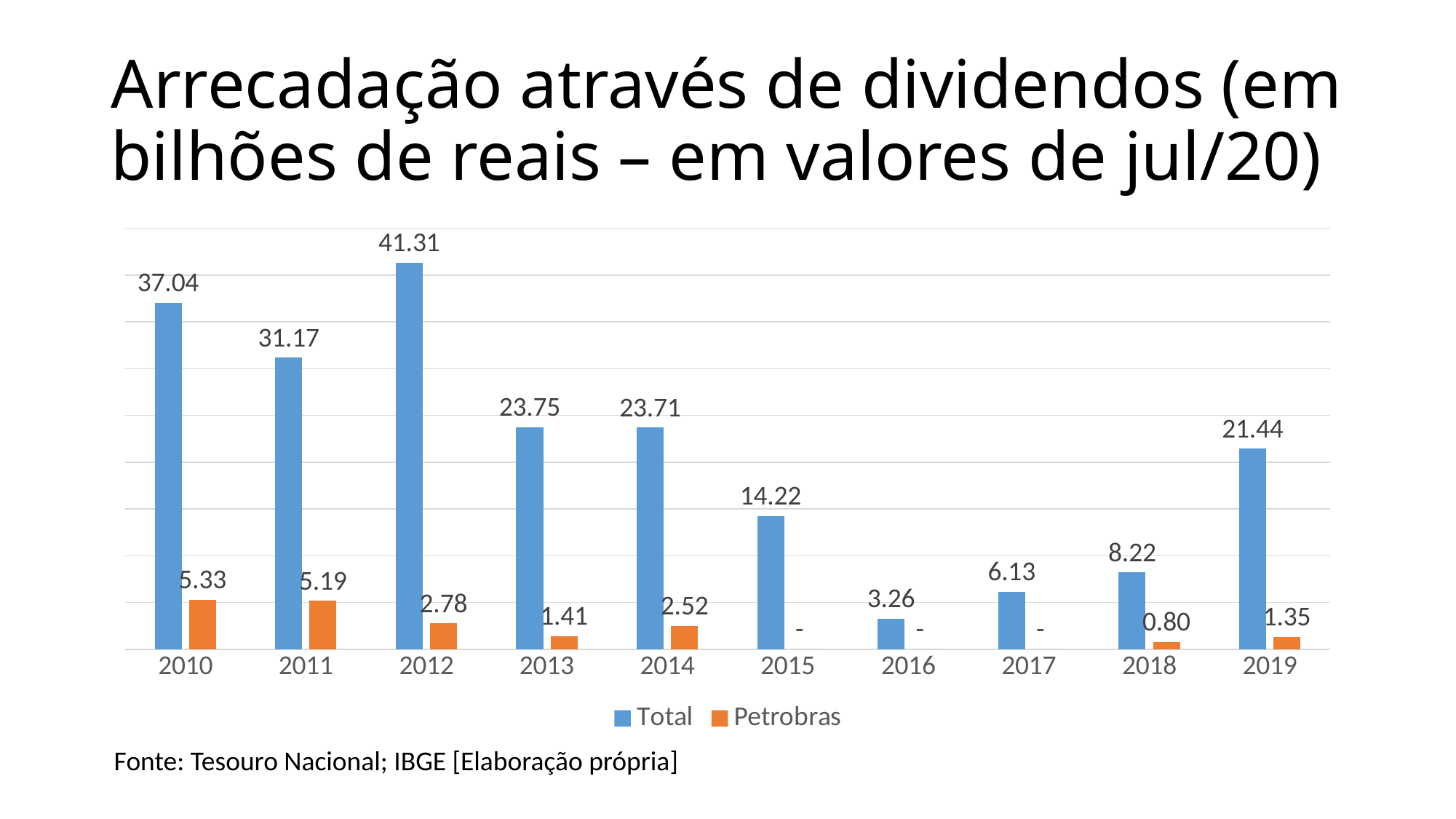
Which series is shown in orange? Petrobras What is the Petrobras value for 2010? 5.33 What is the Petrobras value for 2018? 0.80 Which year has the highest Total value? 2012 Which year has the lowest Total value? 2016 What is the difference between the Total values for 2012 and 2011? 10.14 What is the Total value for 2012? 41.31 How many series does the legend list? 2 What kind of chart is shown on the slide? Bar chart How many years are shown on the x axis? 10 What is the Total value for 2019? 21.44 Which is larger, the Petrobras value for 2011 or for 2014? 2011